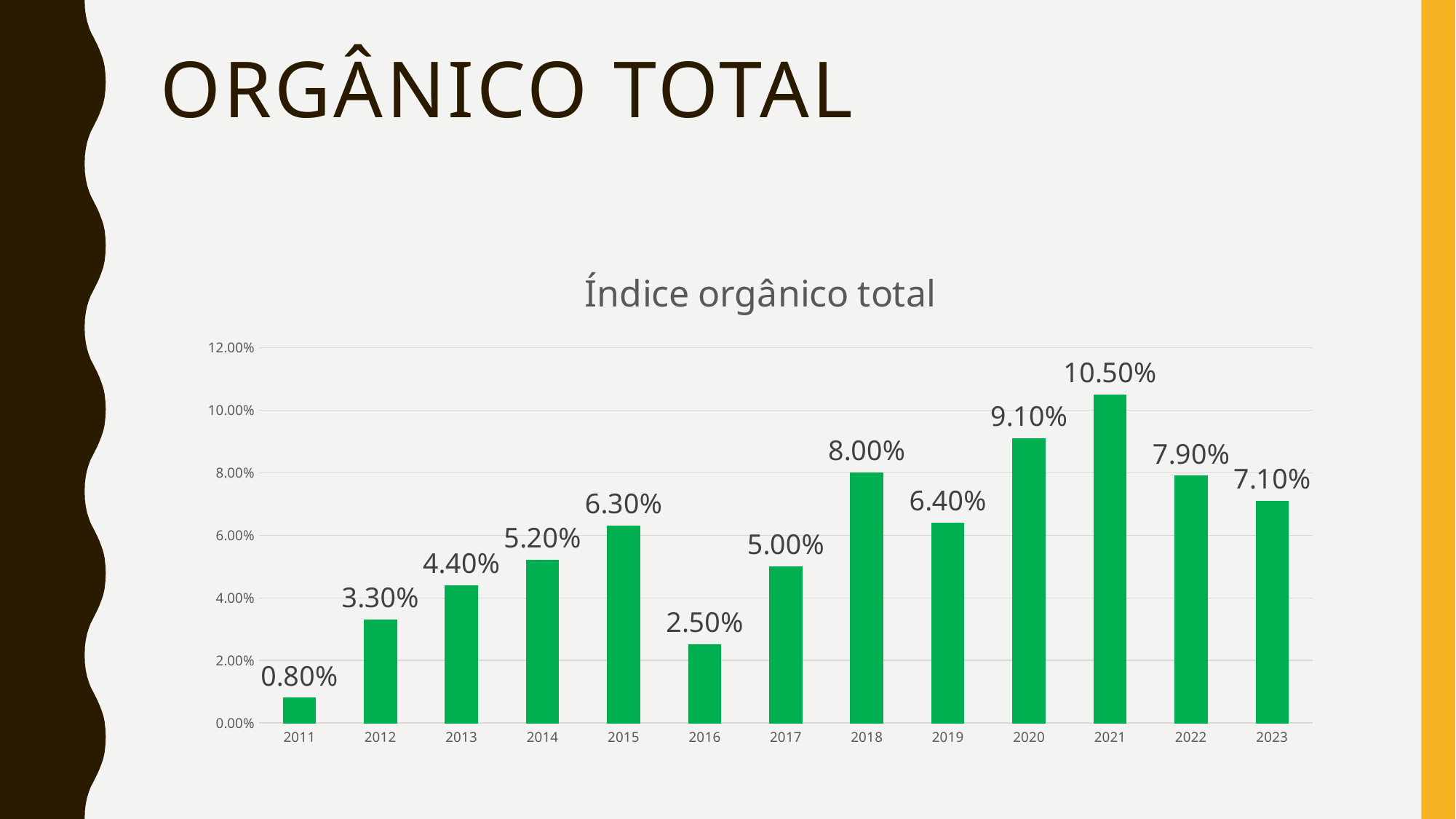
What is the title of the chart? Índice orgânico total What kind of chart is this? Bar chart What is the value for 2016? 2.50% How many years are shown on the x axis? 13 What is the value for 2021? 10.50% What is the value for 2023? 7.10% Which year has the highest value? 2021 Is the value for 2020 greater or less than 8.00%? greater Which year has the lowest value? 2011 What is the value for 2011? 0.80% Which is larger, the value for 2018 or the value for 2019? 2018 What is the difference between the values for 2021 and 2020? 1.40%